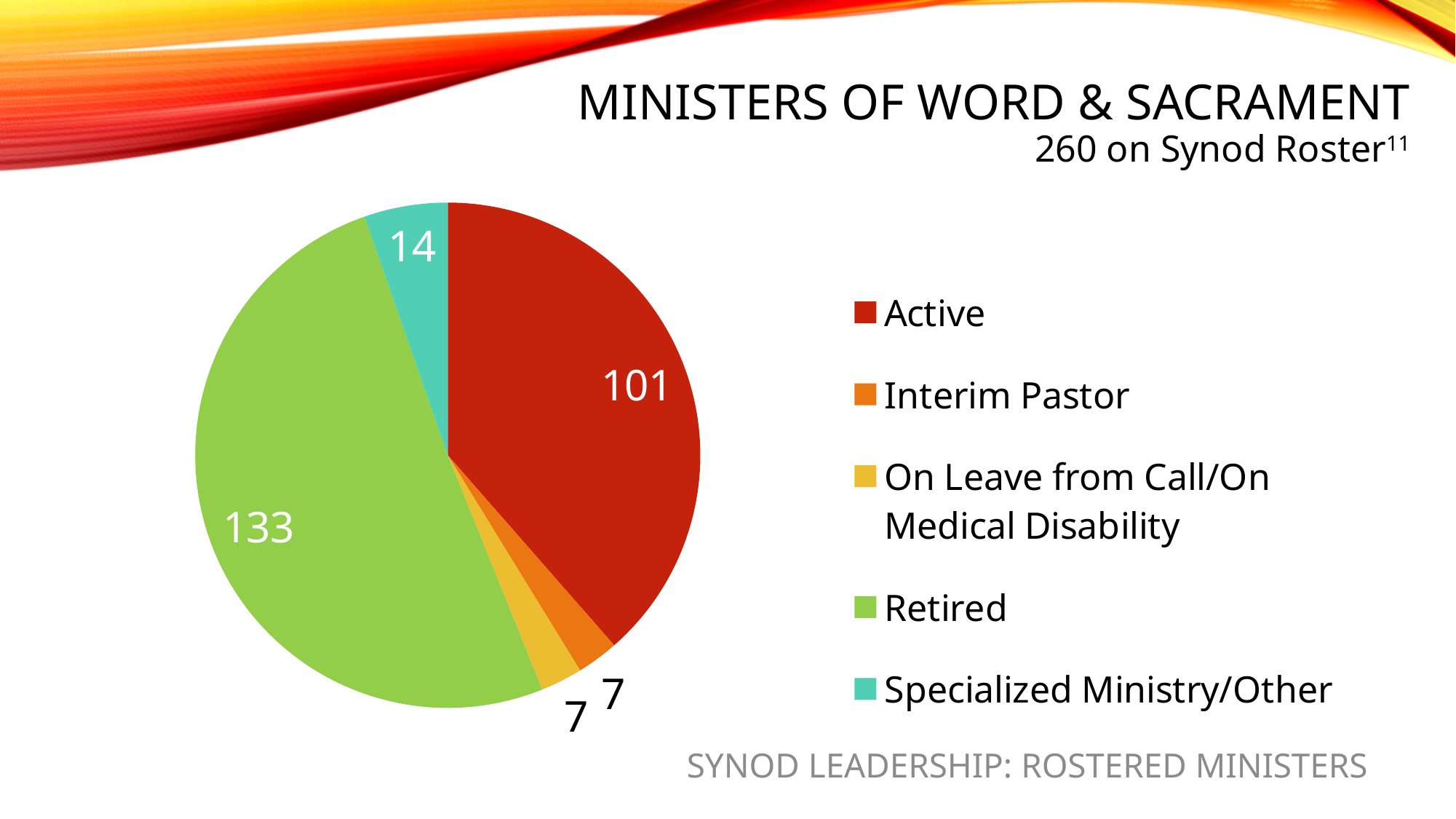
What colour is the Retired slice? green How many categories does the pie chart have? 5 What is the title of the slide containing the chart? Ministers of Word & Sacrament Which is larger, Active or Specialized Ministry/Other? Active How many ministers are shown as Retired? 133 What is the difference between the Retired and Active values? 32 What is the value for Interim Pastor? 7 Which category has the largest slice of the pie? Retired What type of chart is shown on the slide? pie chart What is the value for Specialized Ministry/Other? 14 How many entries does the legend list? 5 How many ministers are shown as Active? 101